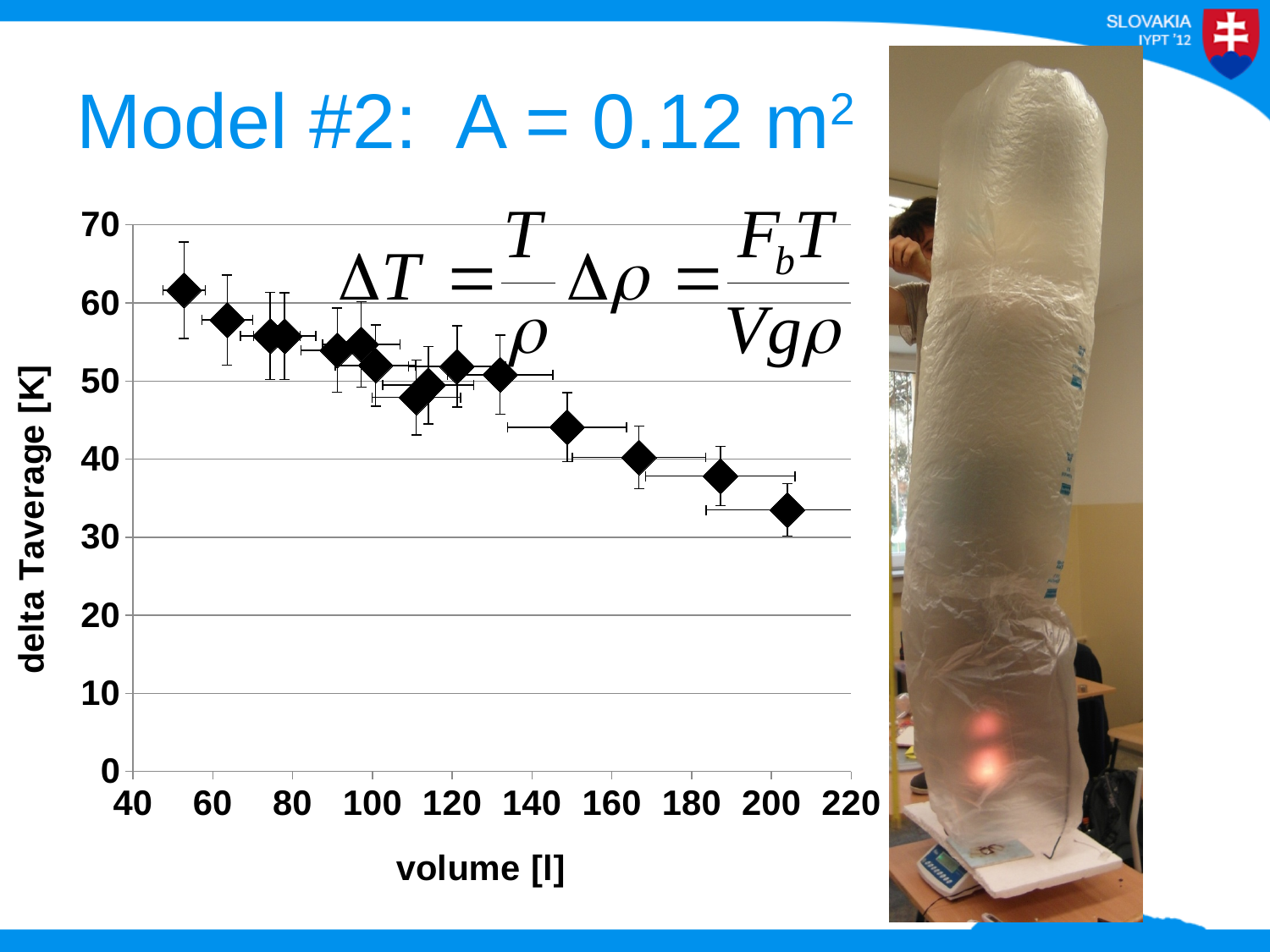
Which has the larger delta Taverage: the point at about 50 l or the point at about 200 l? the point at about 50 l What is the label of the x axis of the chart? volume [l] Is the value for the point at about 150 l greater or less than 50? less Is the value for the rightmost point (volume just over 200 l) greater or less than 40? less What is the highest value shown on the y axis of the chart? 70 Do the plotted values rise or fall as volume increases along the x axis? fall Is the value for the point at about 100 l greater or less than 40? greater At which end of the volume axis is the highest delta Taverage found, the low-volume end or the high-volume end? the low-volume end What is the label of the y axis of the chart? delta Taverage [K] What kind of chart is shown on the slide? scatter chart